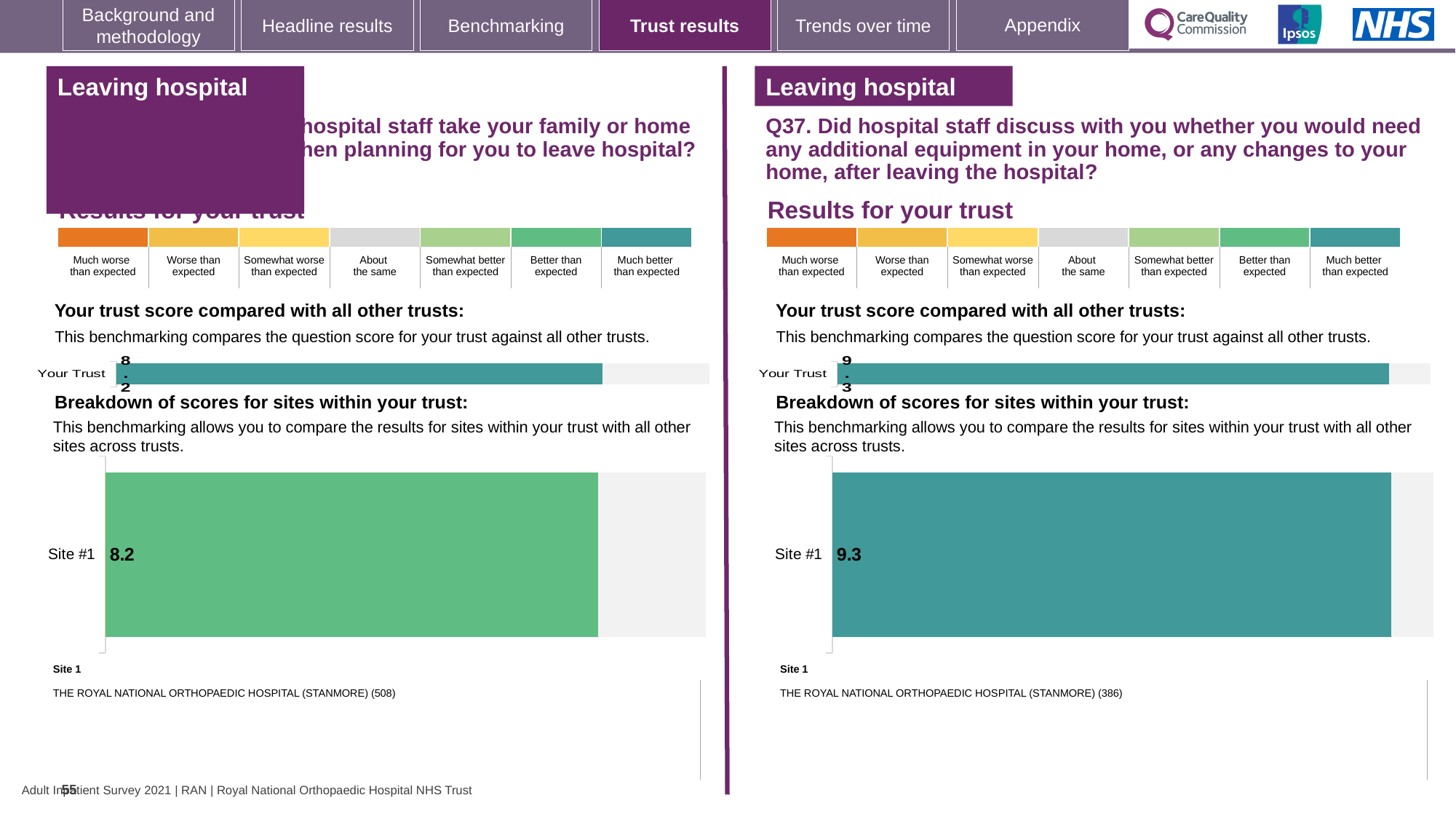
On the right-hand chart (Q37), what is the score shown for Site #1? 9.3 On the left-hand chart, what is the score shown for Your Trust? 8.2 What kind of chart is used to show the breakdown of scores for sites on the right-hand side (Q37)? Bar chart On the left-hand chart, what colour is the Site #1 bar? Green What is the difference between the Site #1 score on the right-hand chart (Q37) and the Site #1 score on the left-hand chart? 1.1 On the right-hand chart (Q37), which site is listed as Site 1? THE ROYAL NATIONAL ORTHOPAEDIC HOSPITAL (STANMORE) (386) How many sites are shown in the site breakdown chart on the right-hand side (Q37)? 1 How many sites are shown in the site breakdown chart on the left-hand side? 1 Which is larger: the Site #1 score on the left-hand chart or the Site #1 score on the right-hand chart (Q37)? Right-hand chart (Q37) On the left-hand chart, what is the score shown for Site #1? 8.2 On the right-hand chart (Q37), what is the score shown for Your Trust? 9.3